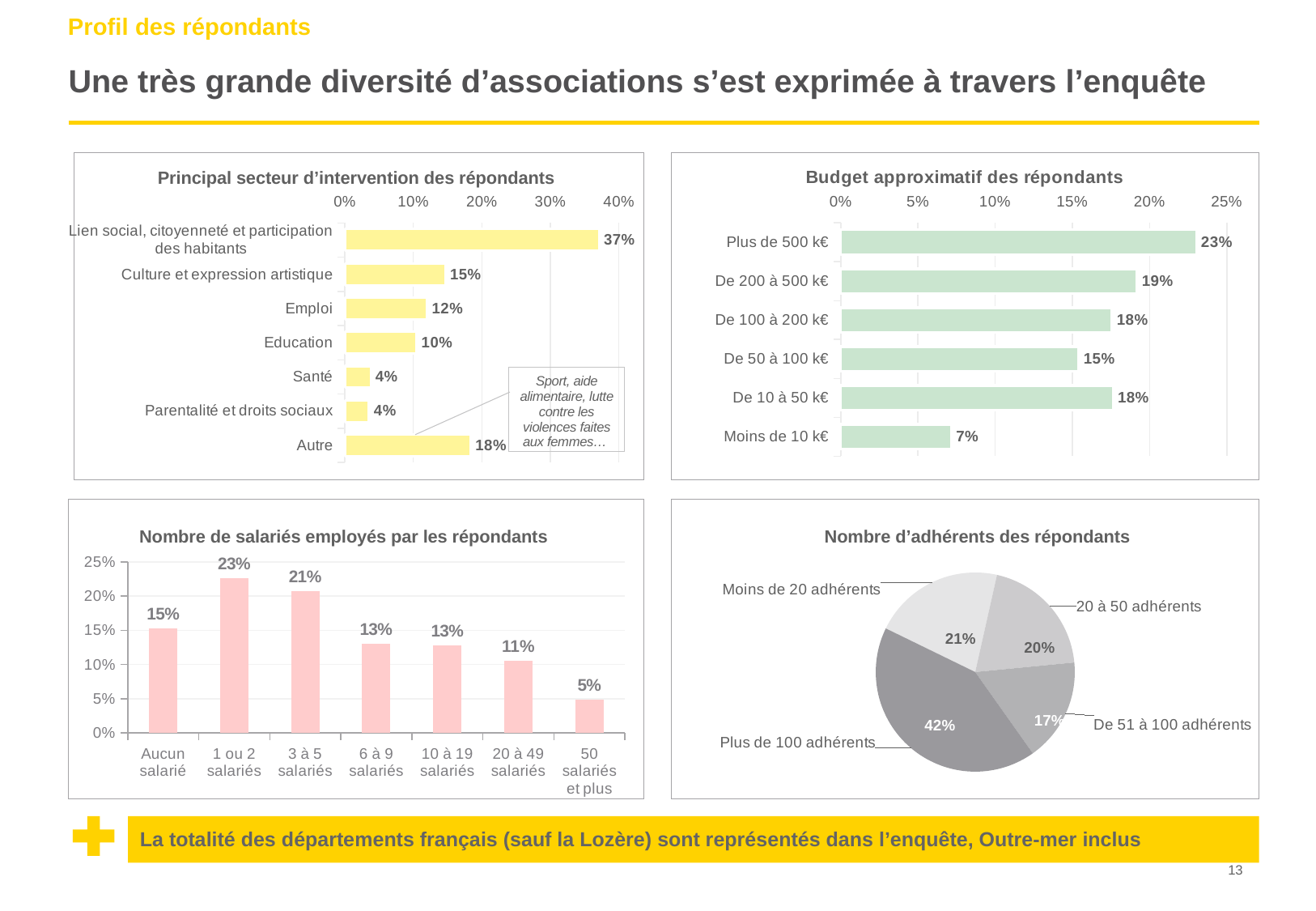
In the chart 'Budget approximatif des répondants', which budget category has the lowest value? Moins de 10 k€ In the chart 'Principal secteur d’intervention des répondants', which sector has the highest value? Lien social, citoyenneté et participation des habitants In the pie chart 'Nombre d’adhérents des répondants', which category has the smallest share? De 51 à 100 adhérents In the pie chart 'Nombre d’adhérents des répondants', what share is 'Plus de 100 adhérents'? 42% In the chart 'Principal secteur d’intervention des répondants', what is the difference between 'Autre' and 'Emploi'? 6% How many categories are shown in the chart 'Principal secteur d’intervention des répondants'? 7 In the chart 'Nombre de salariés employés par les répondants', what is the value for '1 ou 2 salariés'? 23% In the chart 'Principal secteur d’intervention des répondants', what is the value for 'Culture et expression artistique'? 15% In the chart 'Budget approximatif des répondants', which is larger: 'Plus de 500 k€' or 'De 200 à 500 k€'? Plus de 500 k€ In the chart 'Budget approximatif des répondants', what is the value for 'De 50 à 100 k€'? 15% What type of chart is 'Nombre de salariés employés par les répondants'? Bar chart In the chart 'Nombre de salariés employés par les répondants', what is the difference between '3 à 5 salariés' and '50 salariés et plus'? 16%